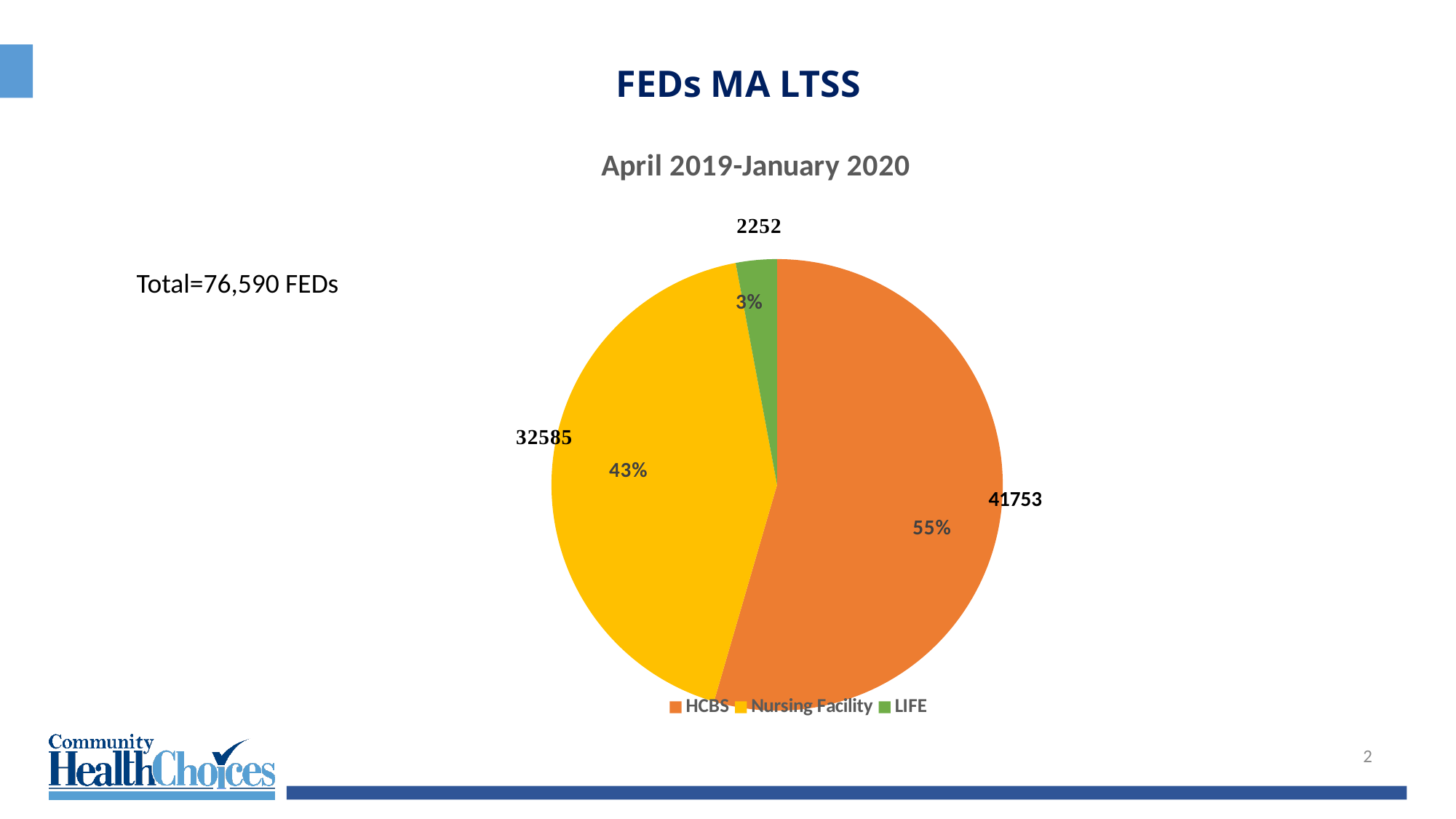
Which category has the smallest slice? LIFE What is the value for HCBS? 41753 What is the value for LIFE? 2252 Which category has the largest slice? HCBS What share of the pie does LIFE represent? 3% What share of the pie does Nursing Facility represent? 43% How many categories does the legend list? 3 What share of the pie does HCBS represent? 55% What is the value for Nursing Facility? 32585 What is the chart's title? April 2019-January 2020 What kind of chart is shown on the slide? pie chart What is the difference between the HCBS and Nursing Facility values? 9168